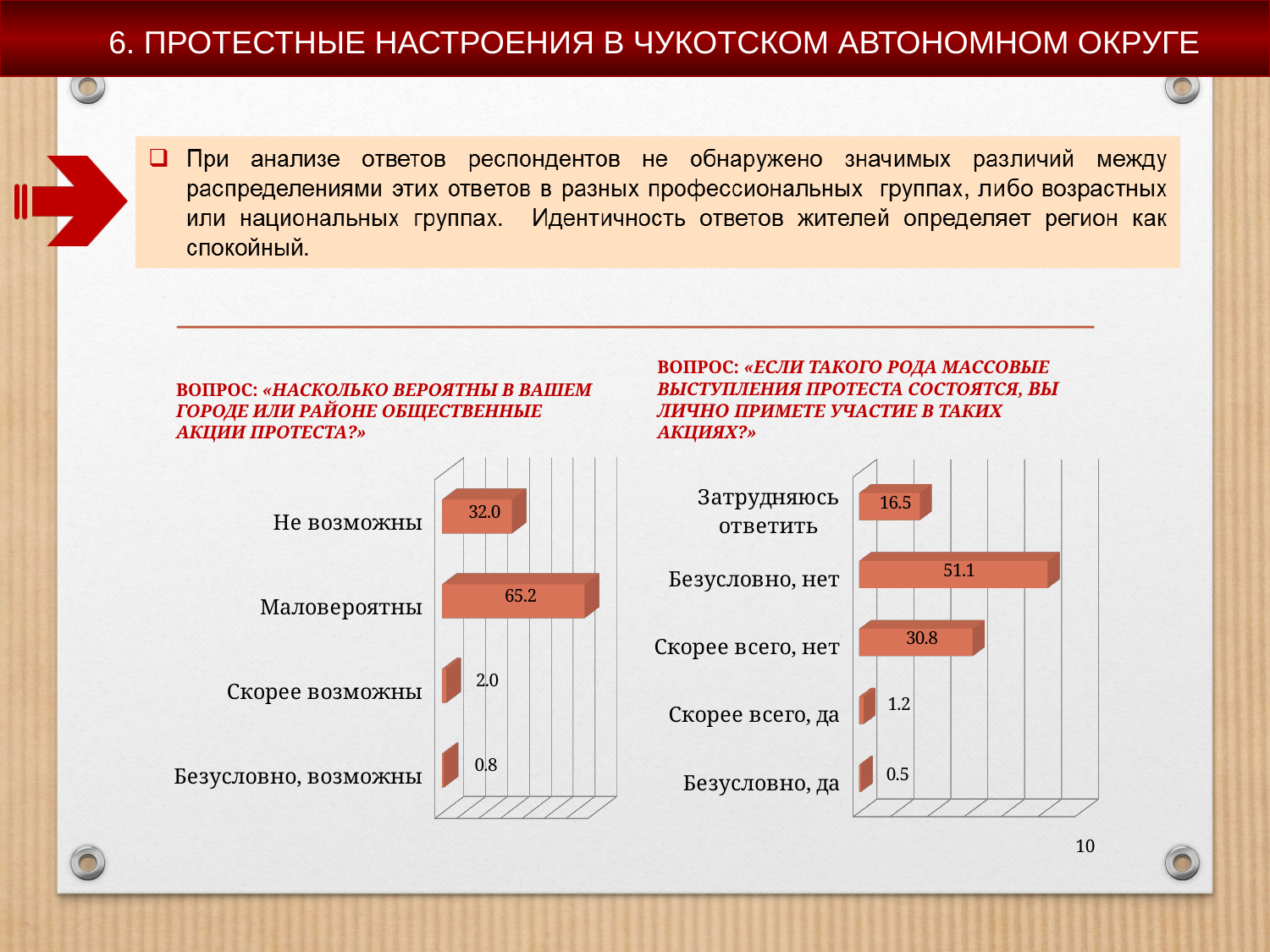
In the left chart, what is the value for "Маловероятны"? 65.2 What type of chart is the left chart? Bar chart In the right chart, what is the value for "Затрудняюсь ответить"? 16.5 In the right chart, which is larger: "Скорее всего, нет" or "Затрудняюсь ответить"? Скорее всего, нет In the left chart, which category has the highest value? Маловероятны In the right chart, which category has the lowest value? Безусловно, да How many categories does the left chart show? 4 In the right chart, what is the value for "Безусловно, нет"? 51.1 In the left chart, what is the value for "Не возможны"? 32.0 In the left chart, what is the difference between "Маловероятны" and "Не возможны"? 33.2 How many categories does the right chart show? 5 In the right chart, what is the difference between "Безусловно, нет" and "Скорее всего, нет"? 20.3